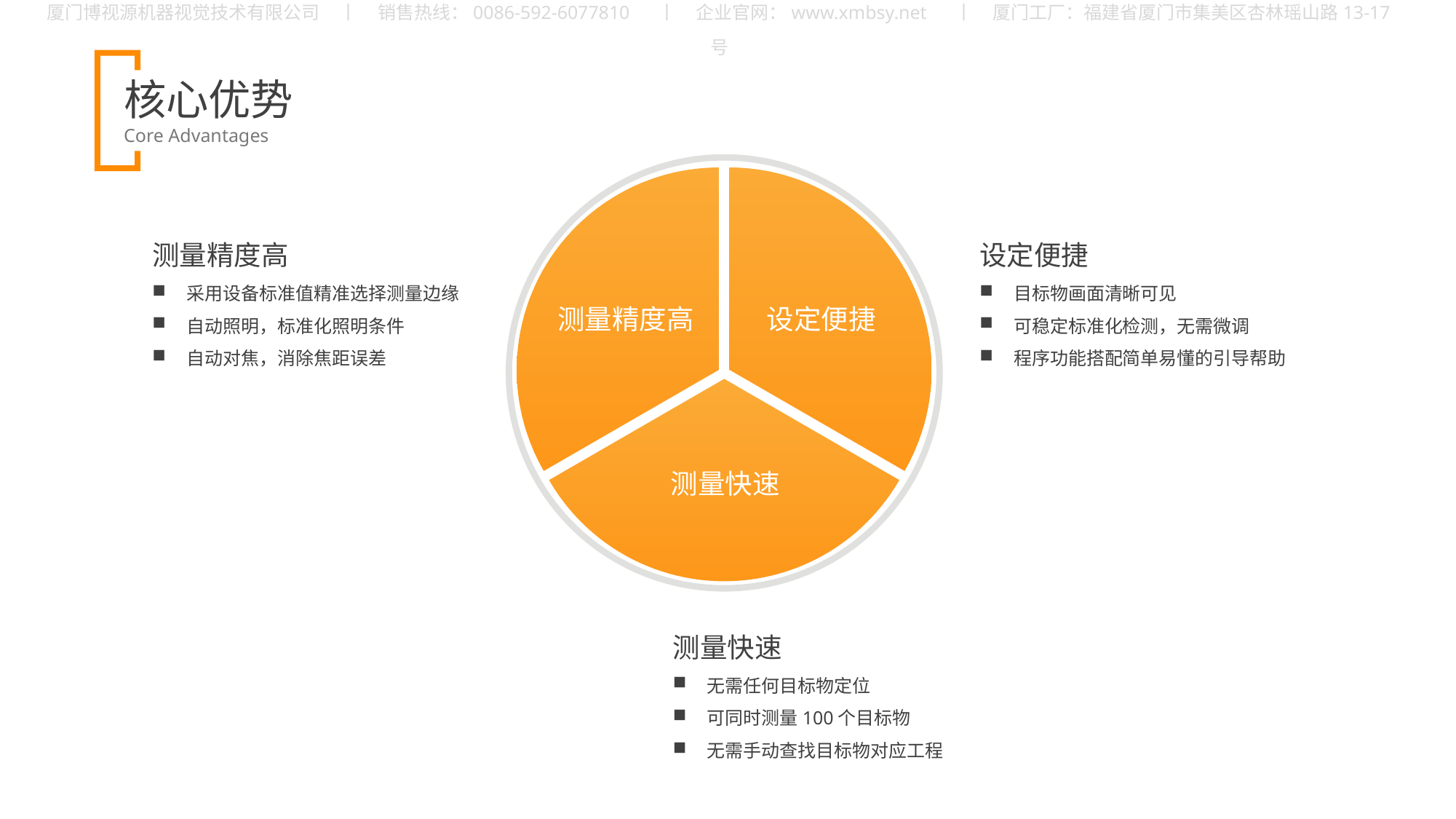
What is the label of the slice on the upper left of the pie chart? 测量精度高 Are the three slices of the pie chart equal in size? yes What is the label of the slice at the bottom of the pie chart? 测量快速 What kind of chart is shown in the centre of the slide? pie chart How many slices does the pie chart have? 3